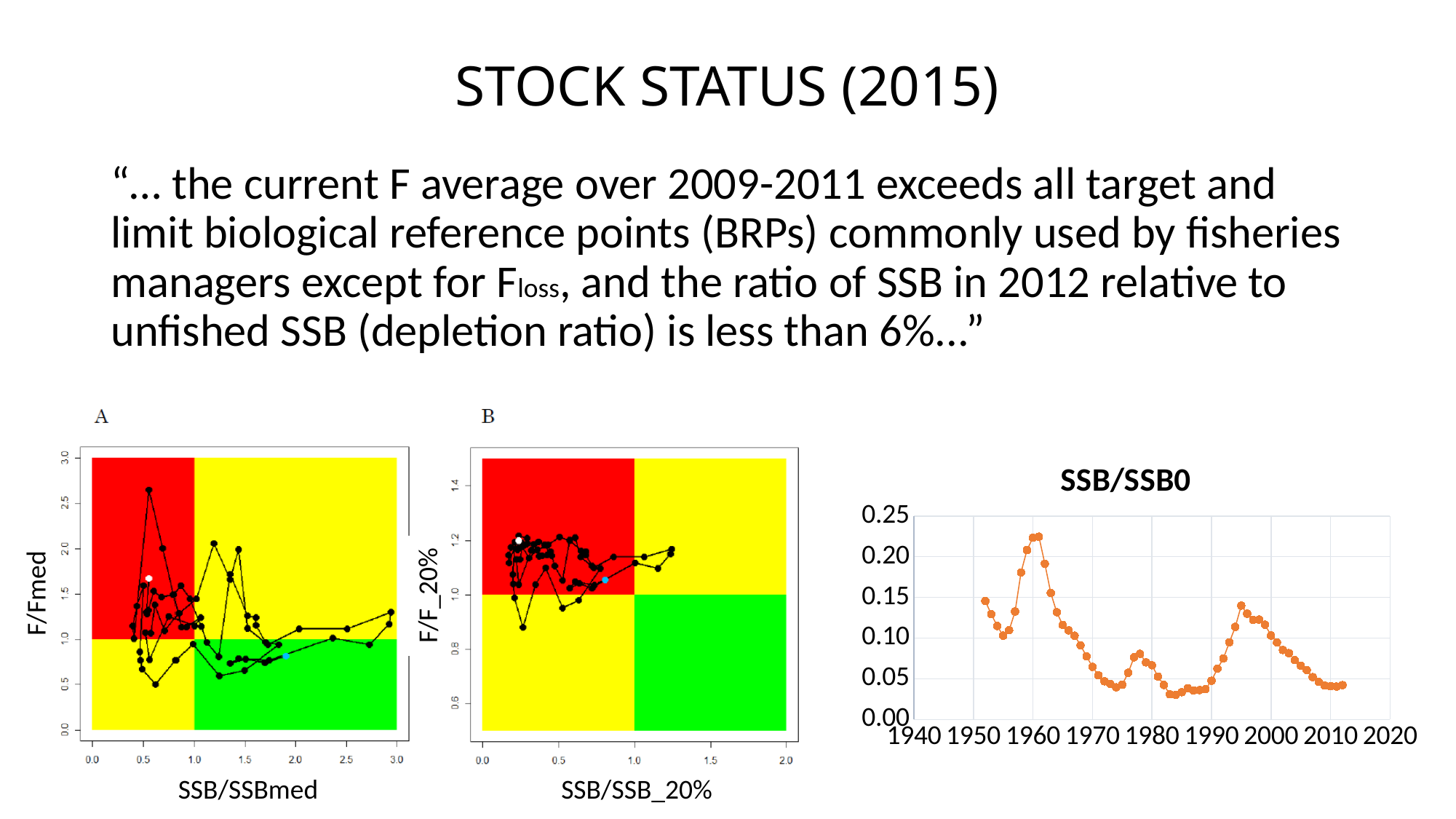
In the SSB/SSB0 chart, is the peak value around 1960 greater or less than 0.20? greater In the SSB/SSB0 chart, is the value around 1985 greater or less than 0.05? less In chart B, what is the y-axis label? F/F_20% In the SSB/SSB0 chart, do the values rise or fall between 1985 and 1995? rise What kind of chart is the SSB/SSB0 chart on the right? line chart In the SSB/SSB0 chart, is the value around 2010 greater or less than 0.05? less In the SSB/SSB0 chart, do the values rise or fall between 1960 and 1970? fall In the SSB/SSB0 chart, is the value around 1960 larger or smaller than the value around 1995? larger What is the x-axis label of chart A? SSB/SSBmed What is the title of the chart on the right of the slide? SSB/SSB0 In the SSB/SSB0 chart, do the values rise or fall between 1995 and 2010? fall